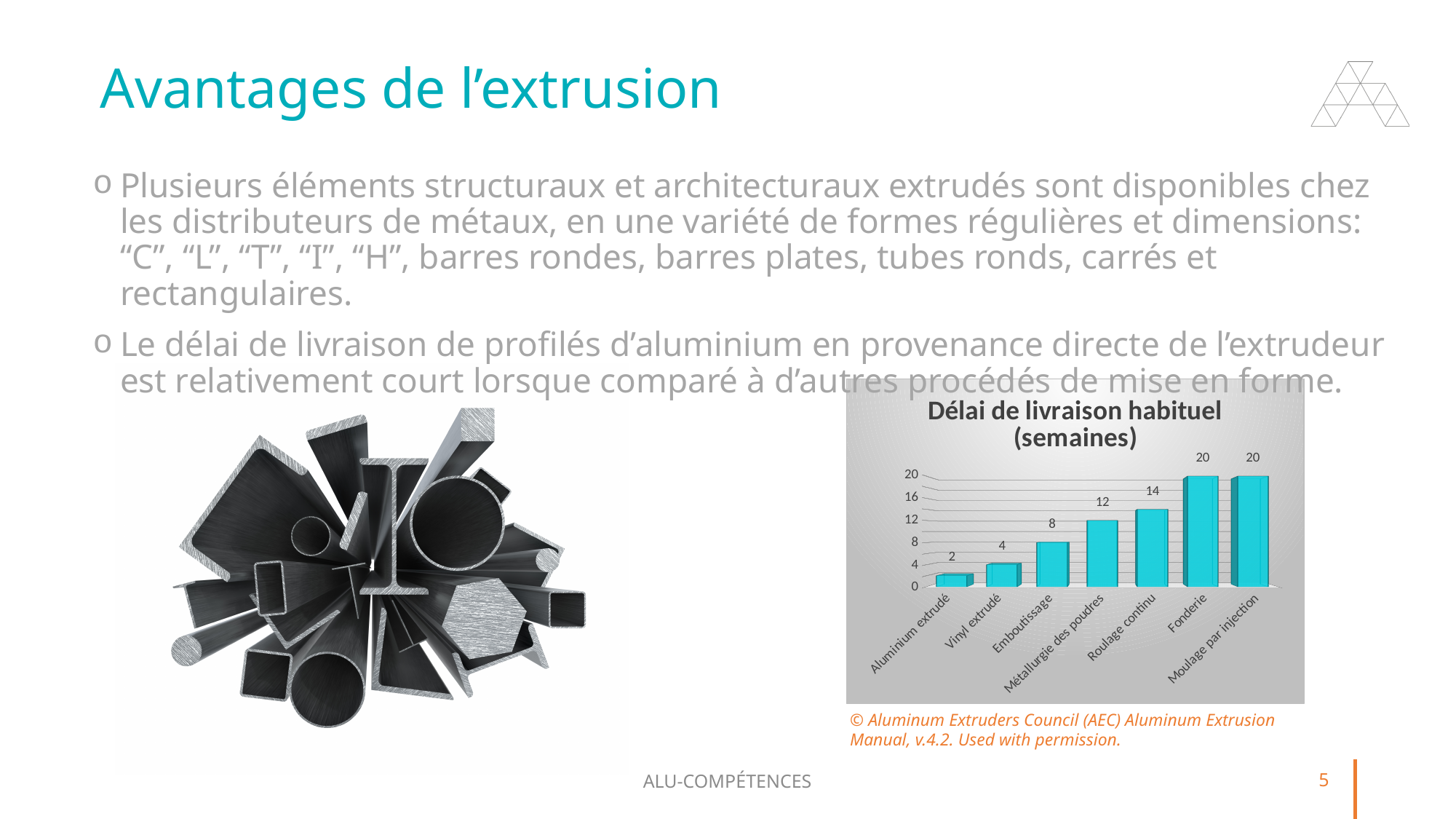
What is the typical delivery time for Aluminium extrudé? 2 What is the difference in delivery time between Emboutissage and Aluminium extrudé? 6 What kind of chart is shown on the slide? bar chart What is the typical delivery time for Métallurgie des poudres? 12 Do the values rise or fall from left to right along the x axis? rise What is the difference in delivery time between Fonderie and Vinyl extrudé? 16 How many categories are shown in the chart? 7 Is the value for Métallurgie des poudres greater or less than 8? greater What is the title of the chart? Délai de livraison habituel (semaines) What is the typical delivery time for Roulage continu? 14 Which category has the lowest delivery time? Aluminium extrudé Which has a longer delivery time, Emboutissage or Roulage continu? Roulage continu